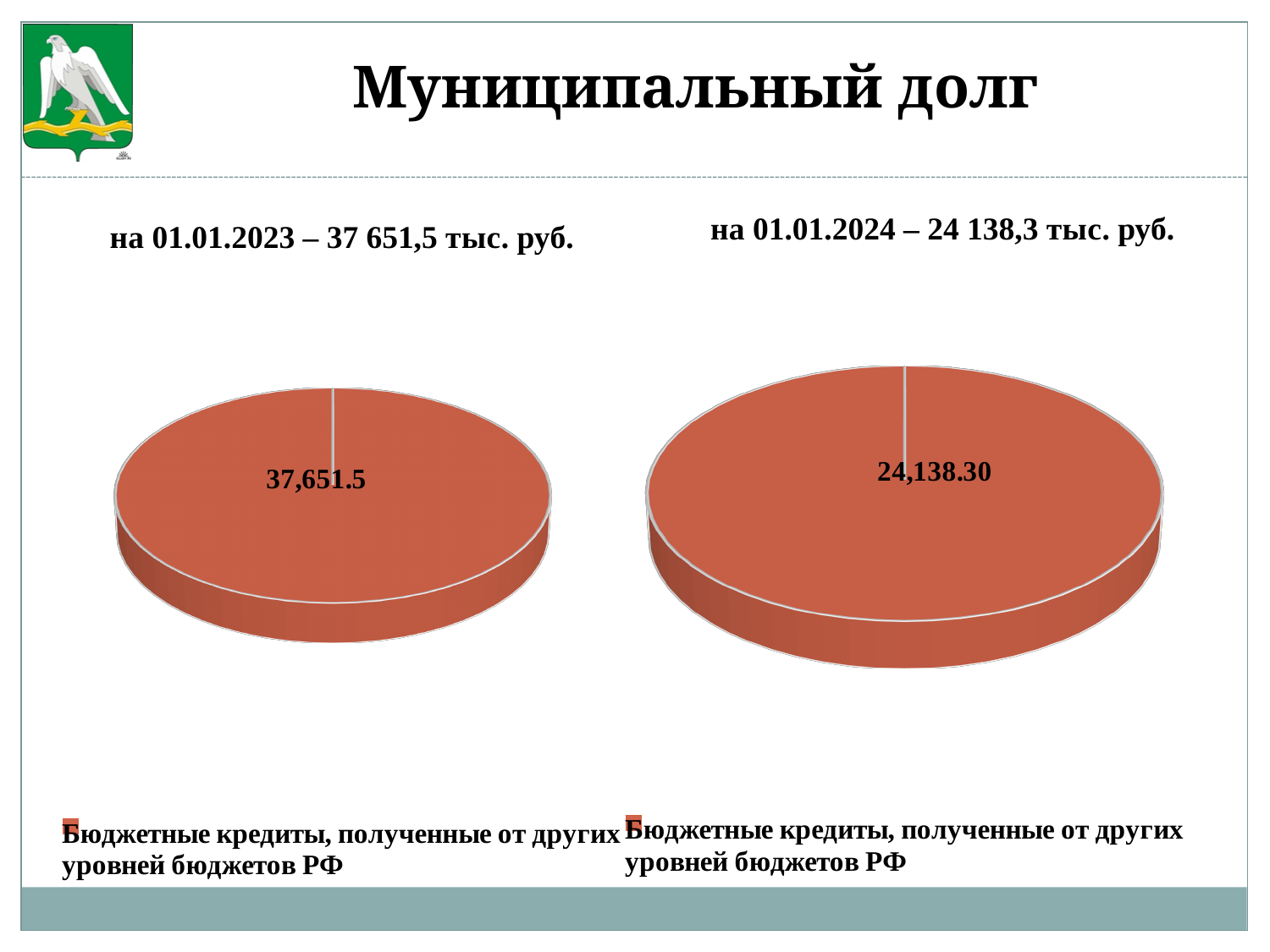
How many slices does the right pie chart (на 01.01.2024) contain? 1 In the right pie chart (на 01.01.2024), what share of the pie does the single slice represent? 100% In the right pie chart (на 01.01.2024), what value is printed on the slice? 24,138.30 How many entries does the legend of the left pie chart list? 1 How many slices does the left pie chart (на 01.01.2023) contain? 1 What is the title of the slide containing the two pie charts? Муниципальный долг What kind of chart is shown on the left side of the slide? Pie chart Which chart shows the larger value: the left pie chart (на 01.01.2023) or the right pie chart (на 01.01.2024)? The left pie chart (на 01.01.2023) In the left pie chart (на 01.01.2023), what value is printed on the slice? 37,651.5 What is the difference between the value in the left pie chart (37,651.5) and the value in the right pie chart (24,138.30)? 13,513.2 What kind of chart is shown on the right side of the slide? Pie chart What is the legend entry for the slice in the left pie chart? Бюджетные кредиты, полученные от других уровней бюджетов РФ